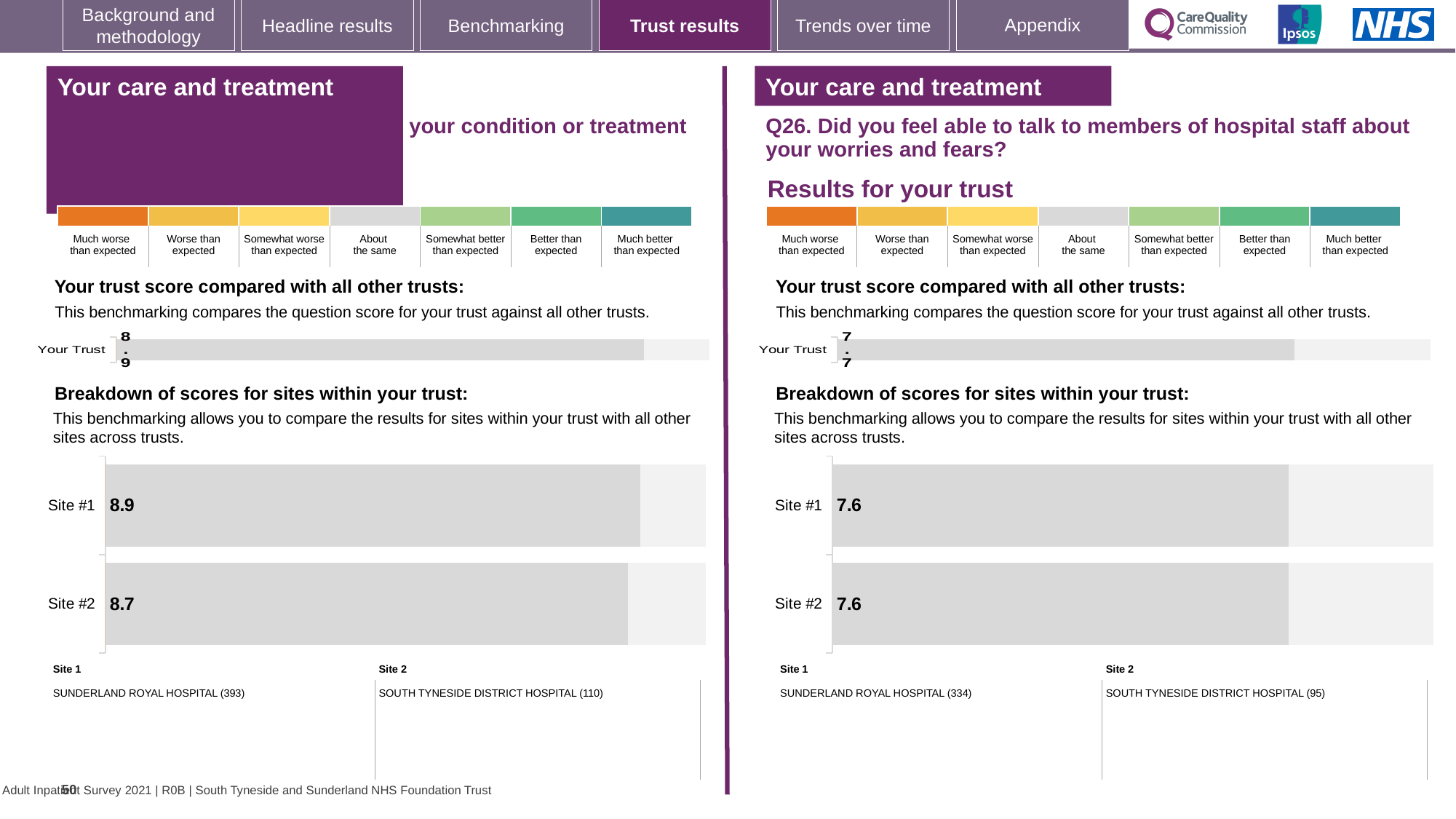
In the left-hand site breakdown chart, what is the difference between the Site #1 and Site #2 scores? 0.2 Is the trust score on the left-hand side of the slide larger or smaller than the trust score on the right-hand side (Q26)? Larger On the left-hand side of the slide, what is the trust score shown in the 'Your trust score compared with all other trusts' chart? 8.9 In the left-hand site breakdown chart, which site has the higher score? Site #1 In the left-hand 'Breakdown of scores for sites within your trust' chart, what is the score for Site #1? 8.9 In the right-hand 'Breakdown of scores for sites within your trust' chart (Q26), what is the score for Site #1? 7.6 In the right-hand 'Breakdown of scores for sites within your trust' chart (Q26), what is the score for Site #2? 7.6 In the right-hand site breakdown chart (Q26), what is the difference between the Site #1 and Site #2 scores? 0 How many sites are shown in the left-hand 'Breakdown of scores for sites within your trust' chart? 2 On the right-hand side of the slide (Q26), what is the trust score shown in the 'Your trust score compared with all other trusts' chart? 7.7 What type of chart is used for the site breakdown on the right-hand side of the slide? Bar chart In the left-hand 'Breakdown of scores for sites within your trust' chart, what is the score for Site #2? 8.7